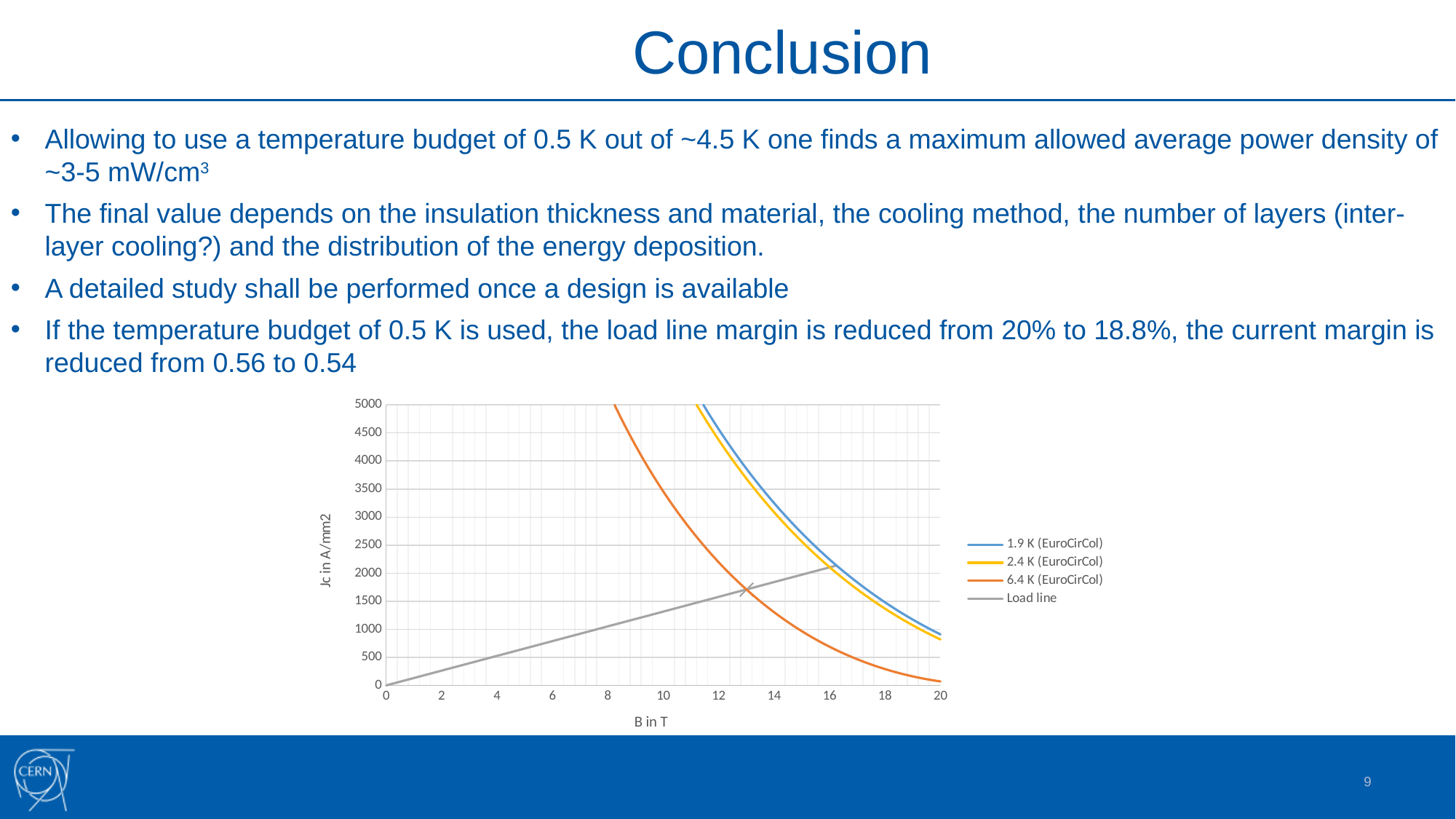
How many series does the chart legend list? 4 Is the value of the 6.4 K (EuroCirCol) curve at B = 16 T greater or less than 1000? less Does the Load line rise or fall as B increases? rise What kind of chart is shown on the slide? line chart What is the title of the vertical axis of the chart? Jc in A/mm2 Is the value of the 6.4 K (EuroCirCol) curve at B = 20 T greater or less than 500? less Does the 6.4 K (EuroCirCol) curve rise or fall as B increases? fall Is the value of the 2.4 K (EuroCirCol) curve at B = 20 T greater or less than 1000? less What is the title of the horizontal axis of the chart? B in T At B = 20 T, which curve has the larger Jc value: 1.9 K (EuroCirCol) or 6.4 K (EuroCirCol)? 1.9 K (EuroCirCol) What is the maximum value shown on the vertical axis of the chart? 5000